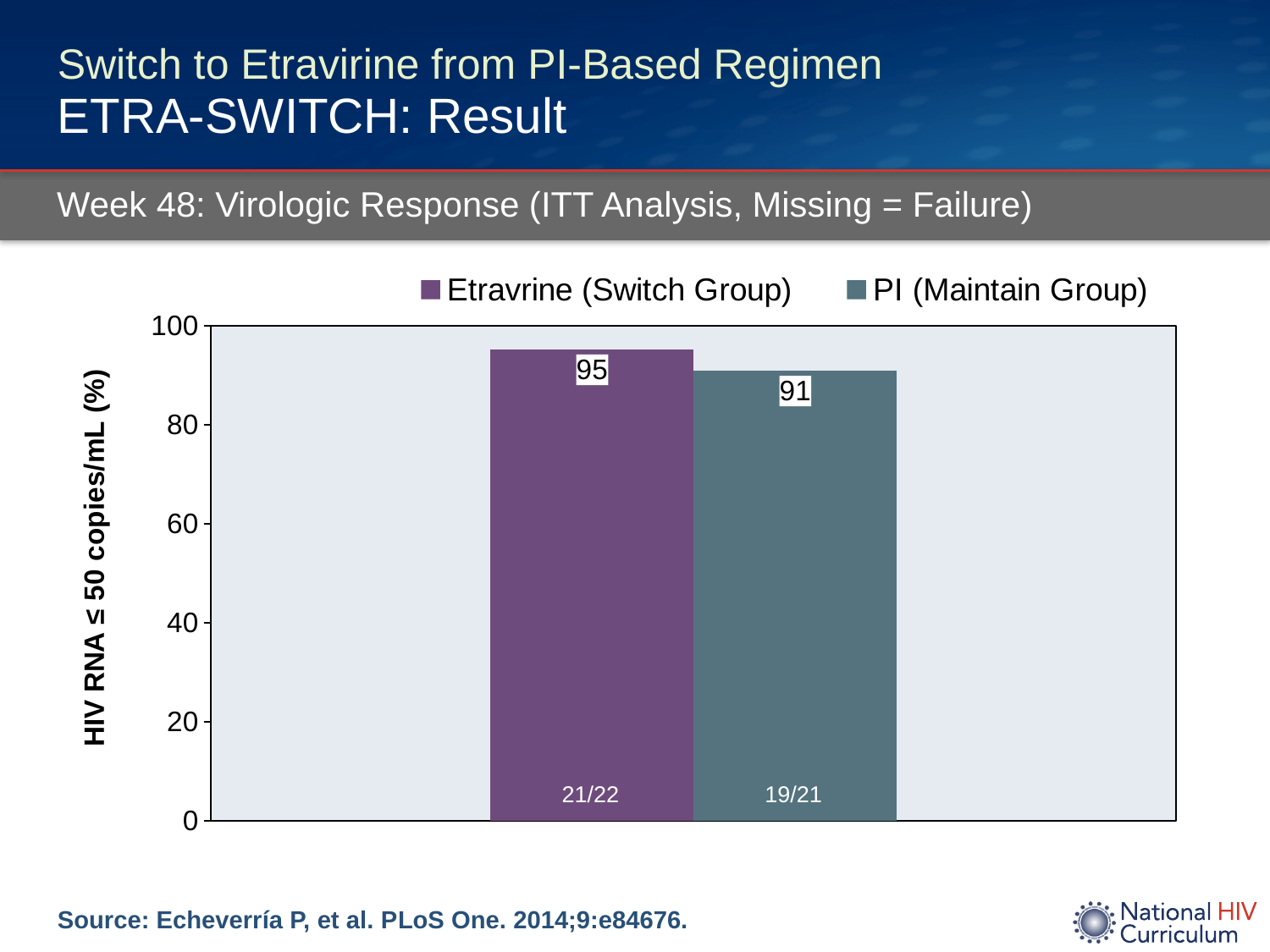
What fraction is printed at the bottom of the Etravrine (Switch Group) bar? 21/22 What is the y-axis label of the chart? HIV RNA ≤ 50 copies/mL (%) What is the value for PI (Maintain Group)? 91 Is the value for Etravrine (Switch Group) larger than the value for PI (Maintain Group)? Yes Which group has the lower value? PI (Maintain Group) Is the value for PI (Maintain Group) greater or less than 80? greater Which group has the higher value? Etravrine (Switch Group) What kind of chart is shown? Bar chart What is the value for Etravrine (Switch Group)? 95 What is the difference between the Etravrine (Switch Group) and PI (Maintain Group) values? 4 How many series does the legend list? 2 What fraction is printed at the bottom of the PI (Maintain Group) bar? 19/21